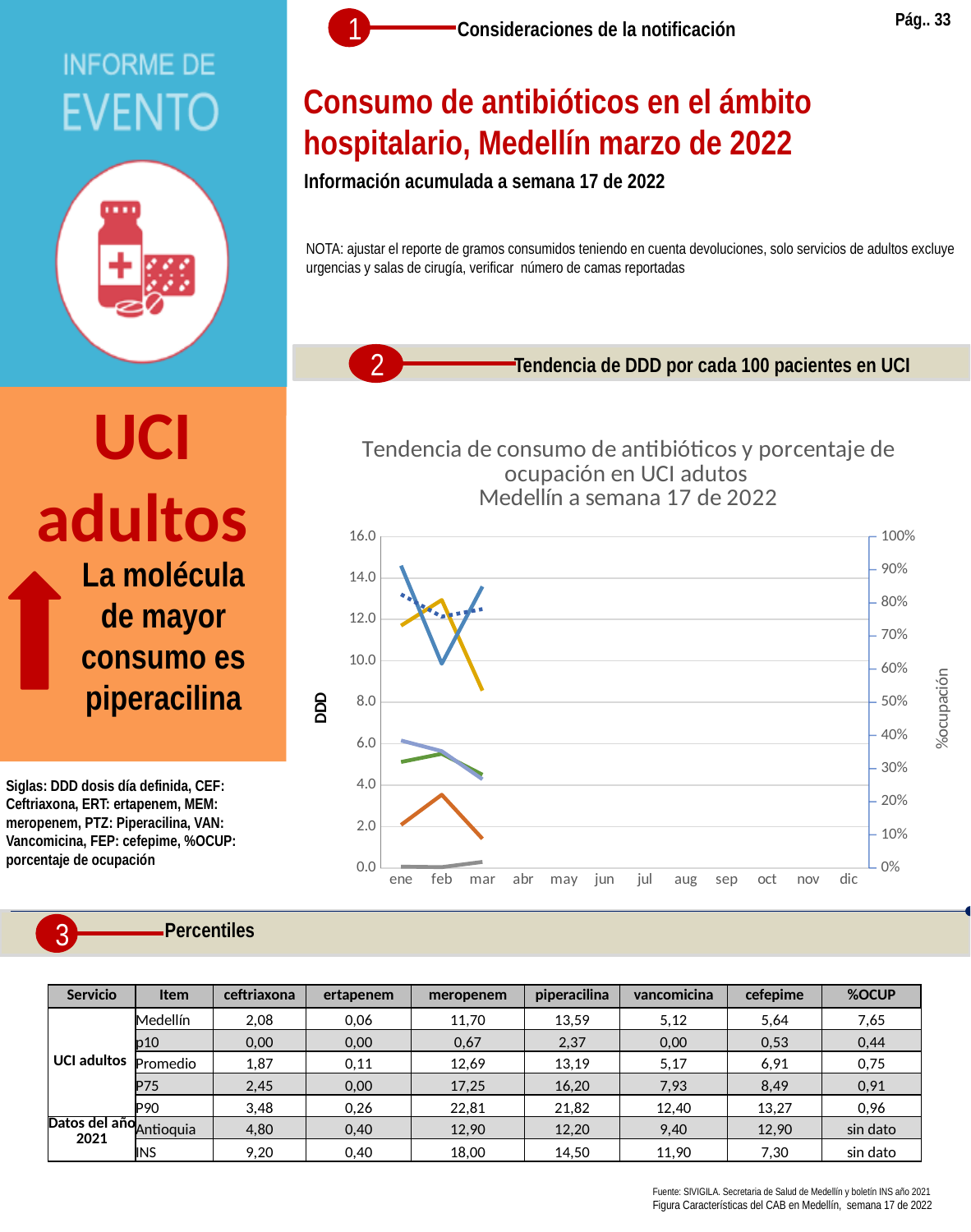
What is the label of the left vertical axis of the line chart? DDD For how many months do the lines in the chart have plotted data? 3 What kind of chart is shown under the heading 'Tendencia de DDD por cada 100 pacientes en UCI'? line chart How many months are listed along the x axis of the line chart? 12 What is the highest value shown on the right vertical axis of the line chart? 100% What is the highest value shown on the left vertical axis of the line chart? 16.0 What is the last month shown on the x axis of the line chart? dic What is the first month shown on the x axis of the line chart? ene What is the title of the line chart? Tendencia de consumo de antibióticos y porcentaje de ocupación en UCI adutos Medellín a semana 17 de 2022